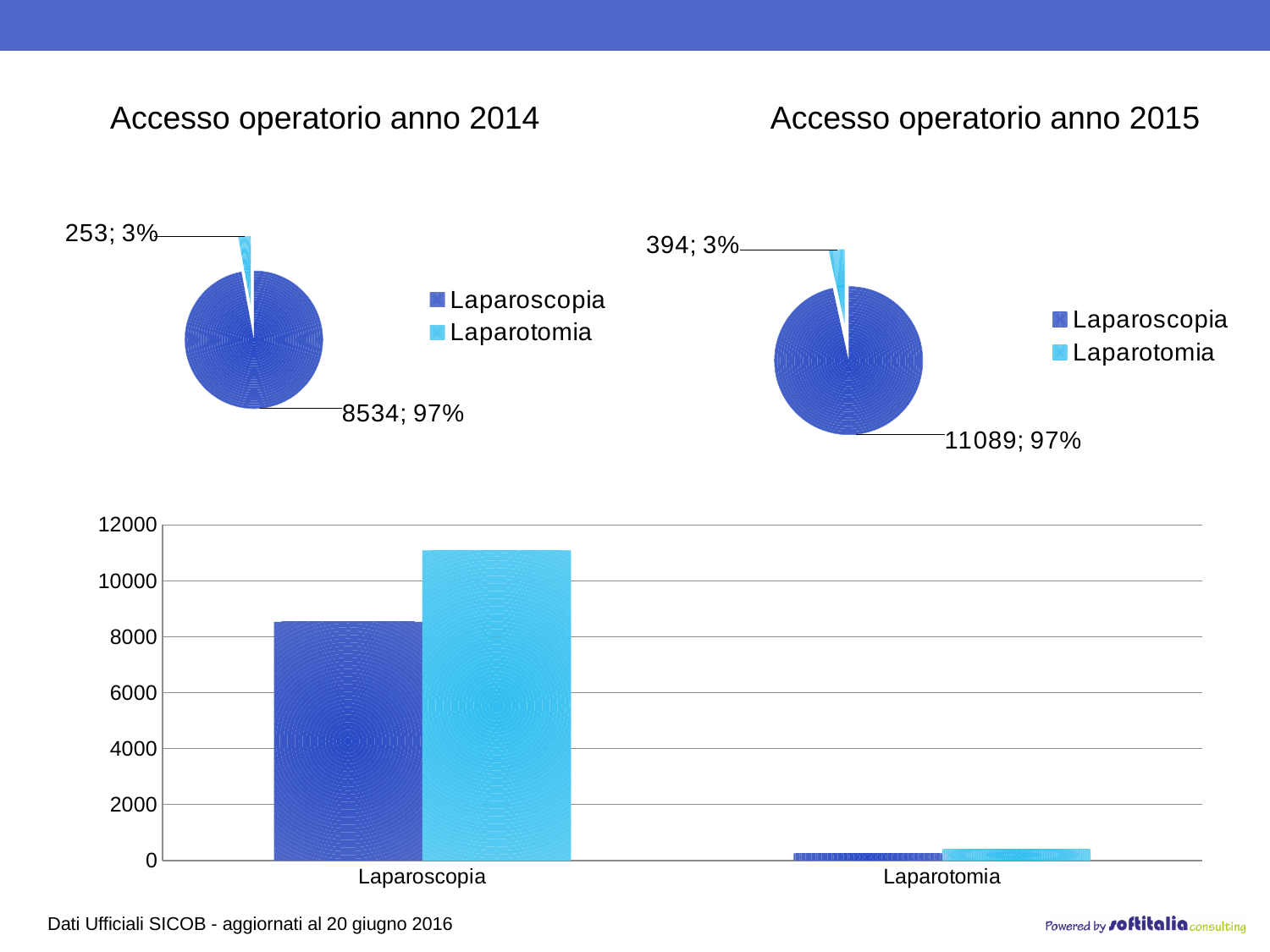
In the bar chart at the bottom of the slide, is the value of the light blue bar for Laparoscopia greater or less than 10000? greater In the 'Accesso operatorio anno 2014' pie chart, what is the value shown for Laparotomia? 253; 3% In the 'Accesso operatorio anno 2014' pie chart, which slice is the largest? Laparoscopia In the 'Accesso operatorio anno 2015' pie chart, what is the value shown for Laparotomia? 394; 3% In the 'Accesso operatorio anno 2015' pie chart, which slice is the smallest? Laparotomia In the 'Accesso operatorio anno 2014' pie chart, what is the value shown for Laparoscopia? 8534; 97% What is the difference between the Laparoscopia count in the 2015 pie chart and the Laparoscopia count in the 2014 pie chart? 2555 How many entries does the legend of the 'Accesso operatorio anno 2014' pie chart list? 2 In the 'Accesso operatorio anno 2015' pie chart, what is the value shown for Laparoscopia? 11089; 97% How many categories are shown on the x axis of the bar chart at the bottom of the slide? 2 In the 'Accesso operatorio anno 2015' pie chart, what share of the pie does Laparoscopia represent? 97% What kind of chart is the chart at the bottom of the slide? Bar chart